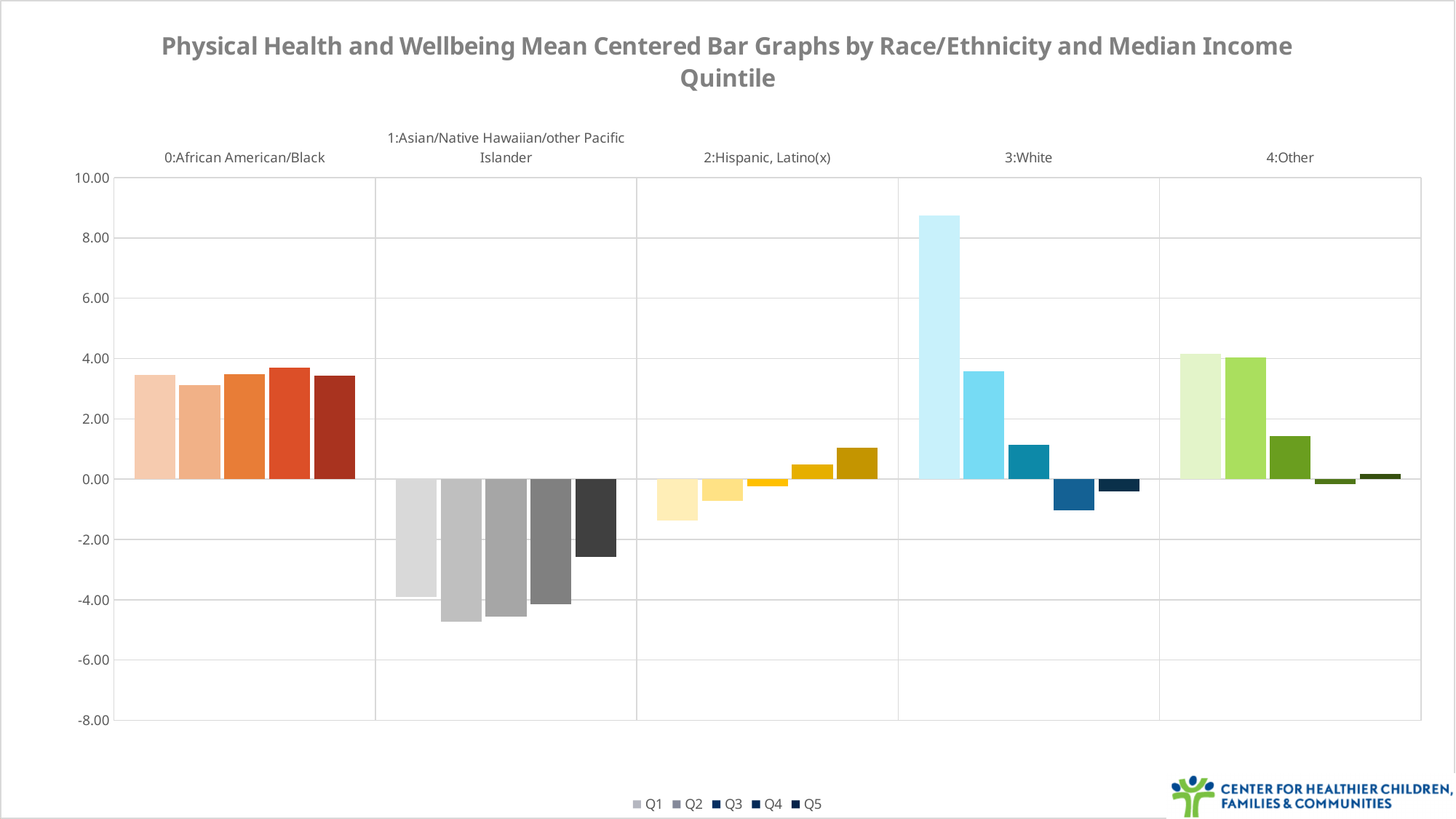
Is the Q1 value for 3:White greater or less than 8.00? greater Do the values for 3:White rise or fall from Q1 to Q4? fall Which race/ethnicity group has all five quintile bars below zero? 1:Asian/Native Hawaiian/other Pacific Islander How many race/ethnicity groups are shown along the x axis? 5 Which race/ethnicity group contains the tallest bar on the chart? 3:White Do the values for 2:Hispanic, Latino(x) rise or fall from Q1 to Q5? rise Which race/ethnicity group contains the lowest bar on the chart? 1:Asian/Native Hawaiian/other Pacific Islander How many series does the legend list? 5 Which is larger, the Q1 value for 3:White or the Q1 value for 4:Other? Q1 value for 3:White What kind of chart is shown on the slide? bar chart Is the Q2 value for 1:Asian/Native Hawaiian/other Pacific Islander greater or less than -4.00? less Is the Q3 value for 4:Other greater or less than 2.00? less